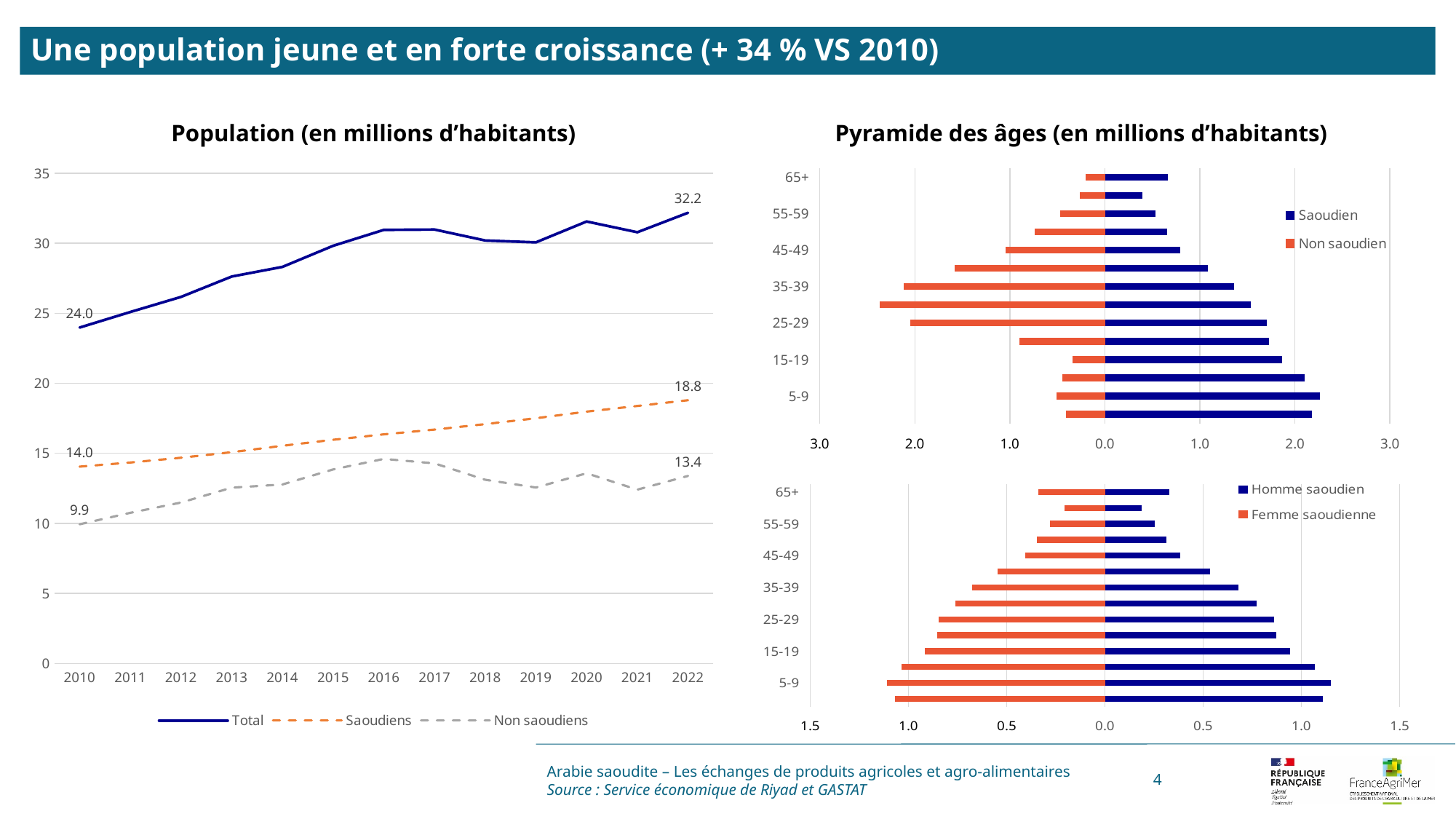
How many series does the legend of the 'Population (en millions d'habitants)' chart list? 3 What are the two legend entries of the lower age pyramid chart on the right of the slide? Homme saoudien and Femme saoudienne In the 'Population (en millions d'habitants)' chart, what is the value of the Total series in 2022? 32.2 In the 'Population (en millions d'habitants)' chart, is the Total value for 2016 greater or less than 30? greater In the 'Population (en millions d'habitants)' chart, which is larger in 2022: Saoudiens or Non saoudiens? Saoudiens In the 'Population (en millions d'habitants)' chart, what is the difference between the Saoudiens value in 2022 and in 2010? 4.8 In the 'Population (en millions d'habitants)' chart, does the Saoudiens series rise or fall from 2010 to 2022? Rise In the 'Population (en millions d'habitants)' chart, by how much did the Total series increase between 2010 and 2022? 8.2 In the 'Population (en millions d'habitants)' chart, what is the value of the Saoudiens series in 2010? 14.0 How many years are shown on the x axis of the 'Population (en millions d'habitants)' chart? 13 In the 'Population (en millions d'habitants)' chart, what is the value of the Non saoudiens series in 2022? 13.4 What kind of chart is the 'Population (en millions d'habitants)' chart? Line chart